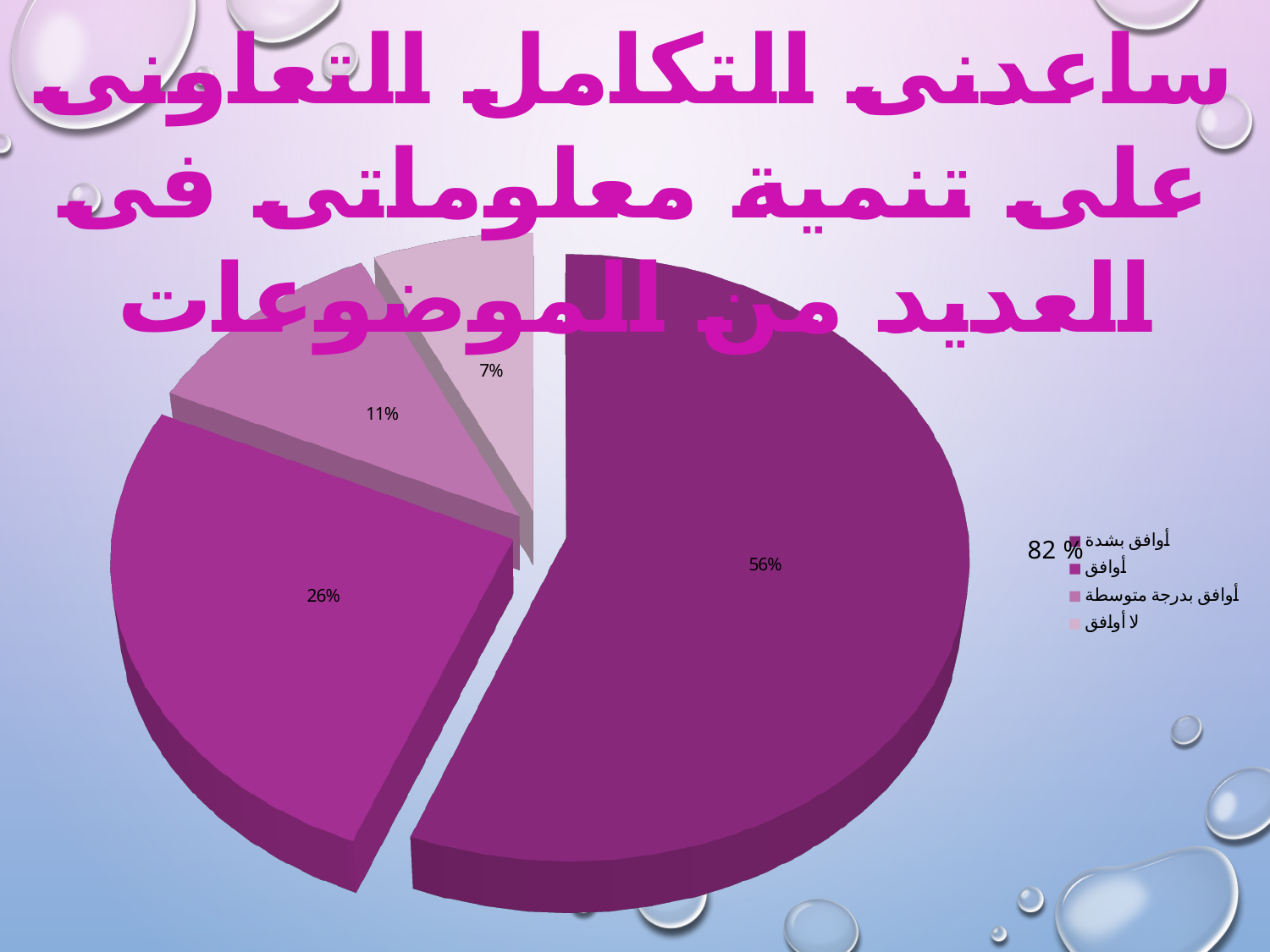
What percentage is shown for the slice "أوافق بدرجة متوسطة"? 11% What kind of chart is shown on the slide? pie chart What is the combined share of the "أوافق بشدة" and "أوافق" slices? 82% What percentage of the pie is labelled for the slice "أوافق بشدة"? 56% How many entries does the legend list? 4 What percentage is shown for the slice "أوافق"? 26% What percentage is shown for the slice "لا أوافق"? 7% How many slices does the pie chart have? 4 What is the difference in percentage points between the "أوافق بشدة" slice and the "أوافق" slice? 30 Which category has the largest slice of the pie? أوافق بشدة Which category has the smallest slice of the pie? لا أوافق Which slice is larger, "أوافق بدرجة متوسطة" or "لا أوافق"? أوافق بدرجة متوسطة